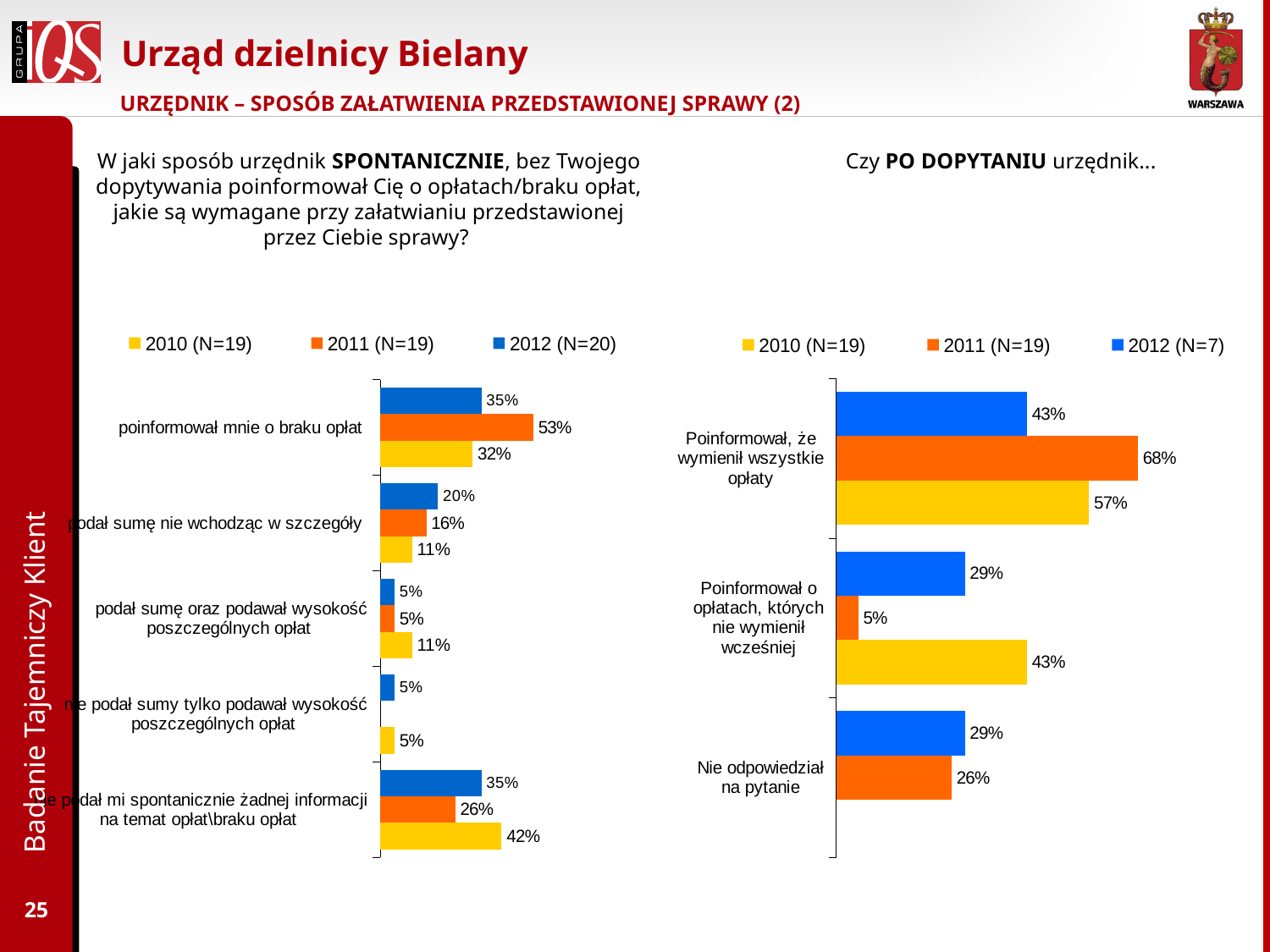
In the left chart (SPONTANICZNIE), what is the difference between the 2011 and 2010 values for 'poinformował mnie o braku opłat'? 21 percentage points In the right chart (PO DOPYTANIU), what sample size is given for the 2012 series in the legend? N=7 In the right chart (PO DOPYTANIU), what is the difference between the 2011 and 2012 values for 'Poinformował, że wymienił wszystkie opłaty'? 25 percentage points In the left chart (SPONTANICZNIE), which series has the highest value for 'poinformował mnie o braku opłat'? 2011 (N=19) In the right chart (PO DOPYTANIU), what is the 2012 (N=7) value for 'Nie odpowiedział na pytanie'? 29% In the right chart (PO DOPYTANIU), what is the 2010 (N=19) value for 'Poinformował, że wymienił wszystkie opłaty'? 57% In the right chart (PO DOPYTANIU), which series has the lowest value for 'Poinformował o opłatach, których nie wymienił wcześniej'? 2011 (N=19) In the left chart (SPONTANICZNIE), which is larger for 'podał sumę oraz podawał wysokość poszczególnych opłat': the 2010 value or the 2012 value? 2010 (N=19) What type of chart is the right chart (PO DOPYTANIU)? Bar chart In the left chart (SPONTANICZNIE), what is the 2011 (N=19) value for 'poinformował mnie o braku opłat'? 53% How many categories does the right chart (PO DOPYTANIU) show? 3 How many series does the legend of the left chart (SPONTANICZNIE) list? 3